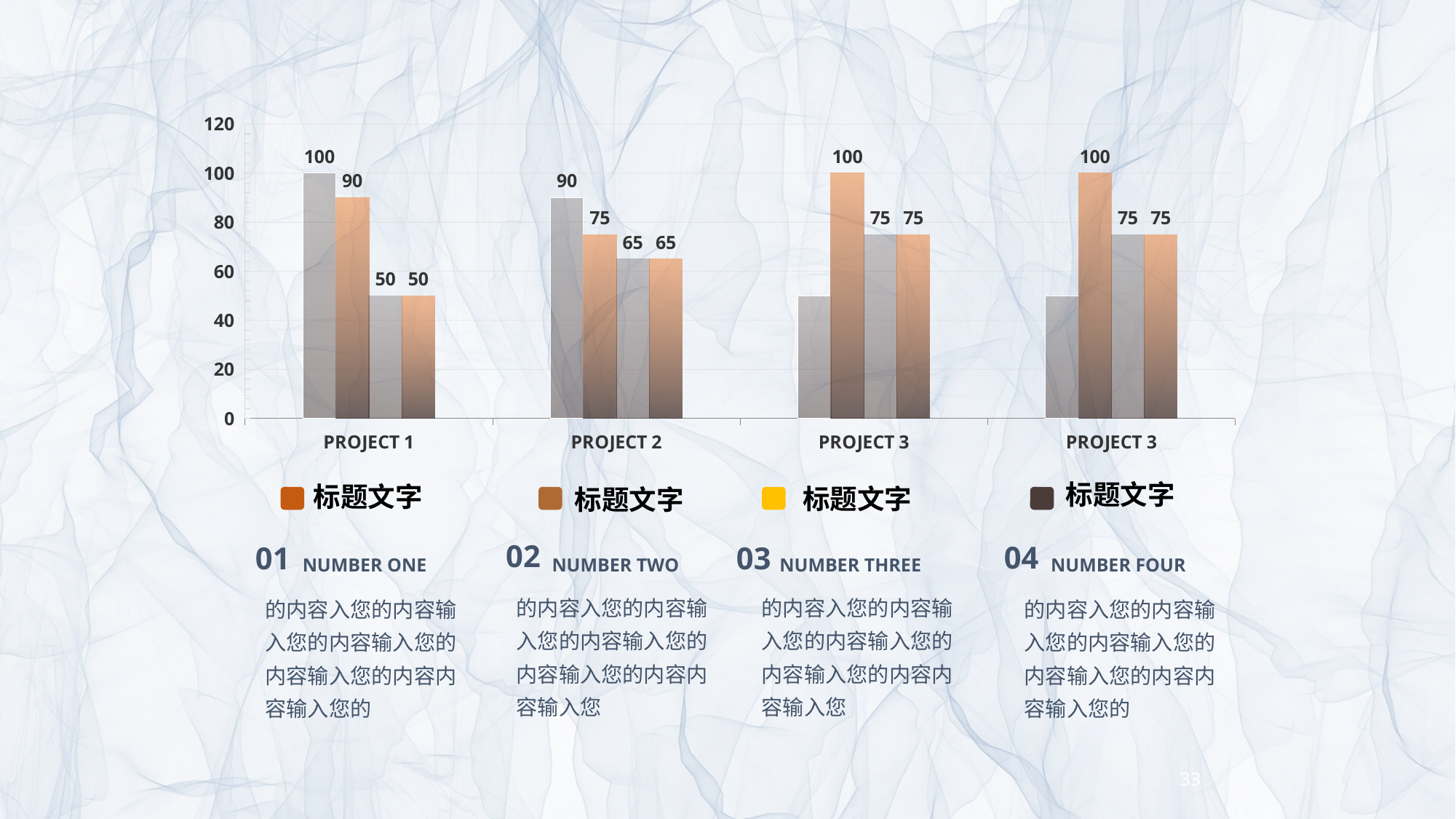
How many category groups are shown on the x axis? 4 Which is larger: the second bar in PROJECT 1 or the second bar in PROJECT 2? The second bar in PROJECT 1 (90) What is the highest value shown on the vertical axis? 120 Is the value of the first (leftmost) bar in the rightmost group greater or less than 60? less What is the difference between the first bar (100) and the third bar (50) in the PROJECT 1 group? 50 What kind of chart is shown on the slide? Bar chart Which bar in the PROJECT 2 group is the tallest? The first (leftmost) bar, 90 What is the value of the second bar in the PROJECT 2 group? 75 Does the value of the first bar in each group rise or fall from PROJECT 1 to the rightmost group? Fall What is the value of the tallest bar in the third group (the first group labelled PROJECT 3)? 100 What is the value of the first (leftmost) bar in the PROJECT 1 group? 100